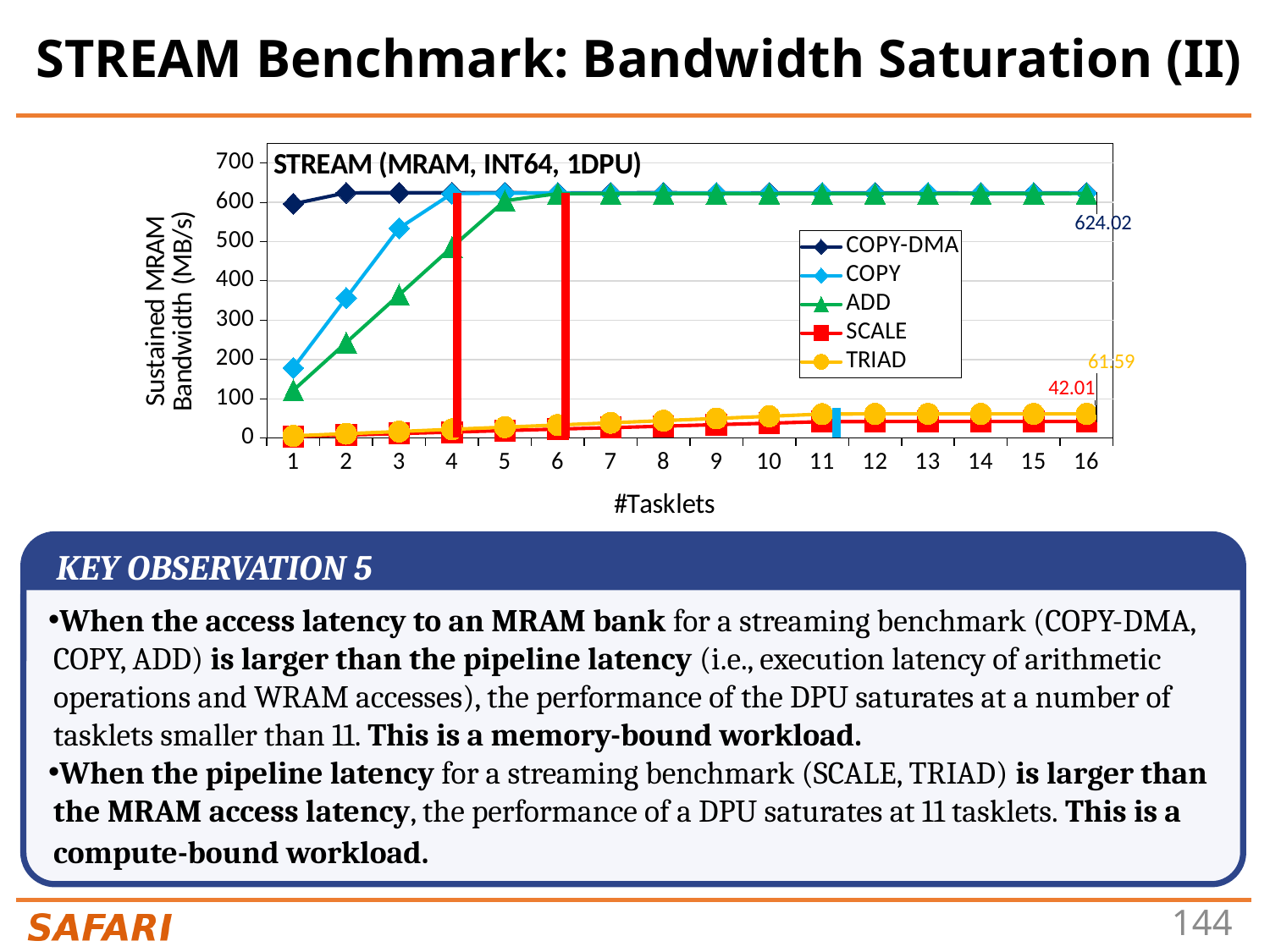
What is the highest data label value printed on the chart? 624.02 How many series does the legend of the STREAM (MRAM, INT64, 1DPU) chart list? 5 How many #Tasklets values are plotted along the x axis? 16 What kind of chart is shown on the slide? line chart At 16 tasklets, which series has the larger value, TRIAD or SCALE? TRIAD What is the data label shown for SCALE at 16 tasklets? 42.01 Is the value for ADD at 1 tasklet greater or less than 200? less Which series has the highest value at 1 tasklet? COPY-DMA What is the data label shown for TRIAD at 16 tasklets? 61.59 What is the difference between the labelled TRIAD value (61.59) and the labelled SCALE value (42.01) at 16 tasklets? 19.58 Is the value for COPY-DMA at 1 tasklet greater or less than 500? greater Does the COPY series rise or fall as #Tasklets increases from 1 to 4? rise